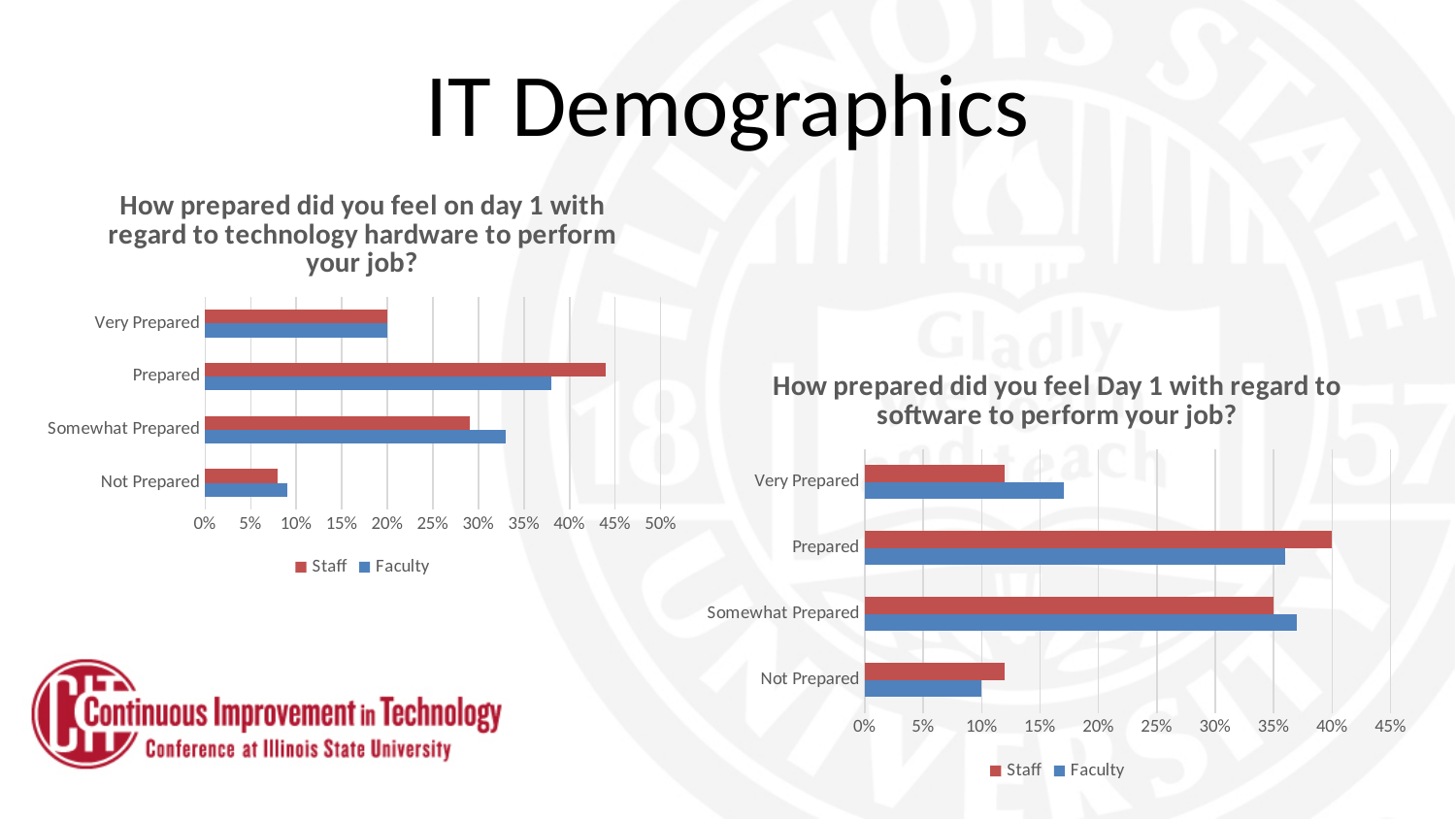
In the hardware chart on the left, how many categories are shown? 4 In the software chart on the right, what colour represents Staff in the legend? red In the hardware chart on the left, is the Staff value for Prepared greater or less than 40%? greater In the hardware chart on the left, is the Faculty value for Not Prepared greater or less than 10%? less In the software chart on the right, is the Faculty value for Very Prepared greater or less than 15%? greater In the hardware chart on the left, how many series does the legend list? 2 In the hardware chart on the left, which category has the highest Staff value? Prepared In the hardware chart on the left, for Somewhat Prepared, which is larger, Staff or Faculty? Faculty In the software chart on the right, which category has the highest Staff value? Prepared In the hardware chart on the left, which category has the lowest Faculty value? Not Prepared In the software chart on the right, for Very Prepared, which is larger, Staff or Faculty? Faculty In the hardware chart on the left, what kind of chart is shown? bar chart